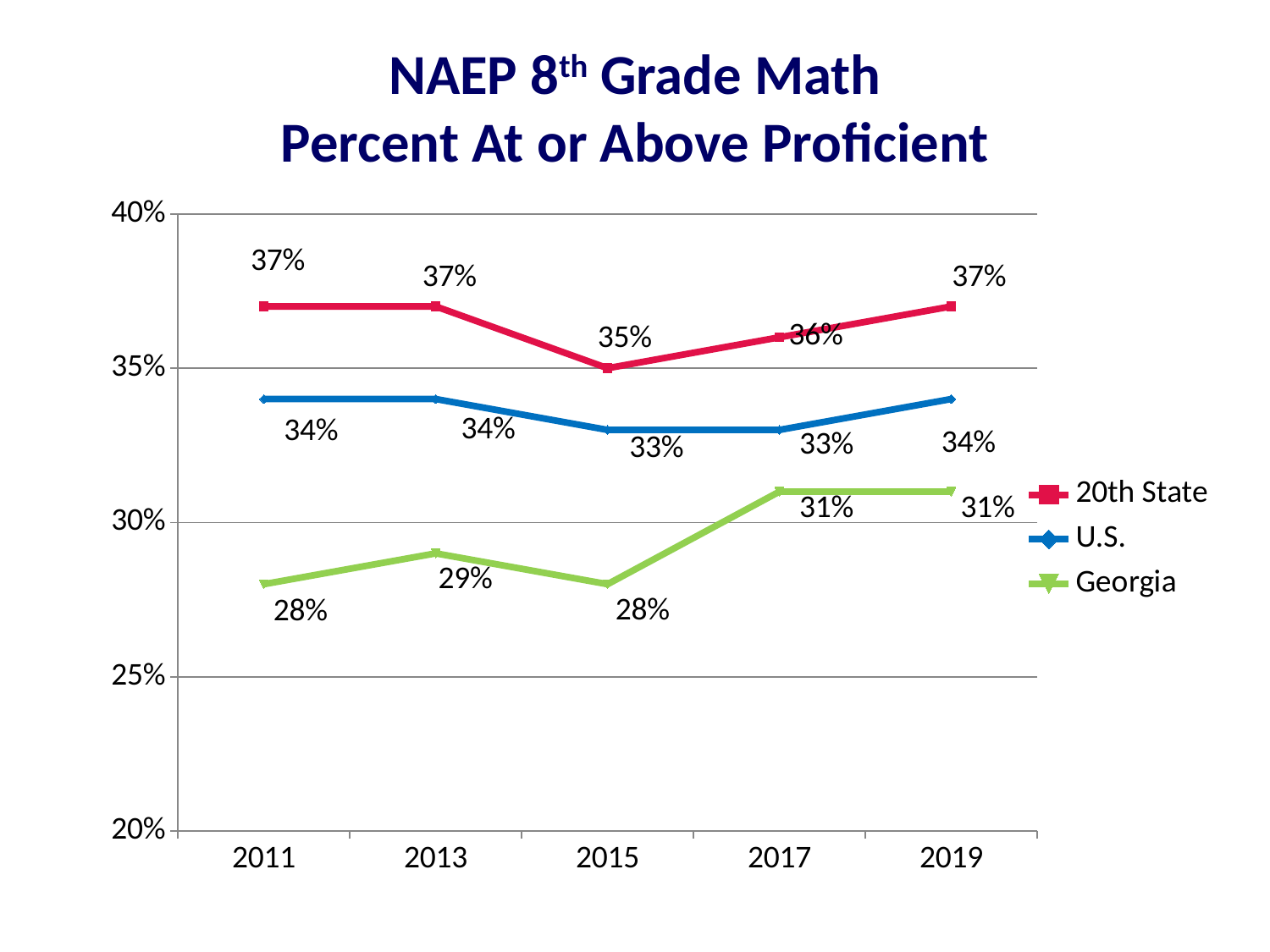
Which was higher in 2017, the U.S. or Georgia? U.S. What is the difference between the 20th State value and Georgia's value in 2011? 9 percentage points How many years are shown on the x axis? 5 What was the 20th State value in 2017? 36% In which year was Georgia's value lowest? 2011 and 2015 What was the U.S. value in 2019? 34% How many series does the legend list? 3 In which year was the 20th State value lowest? 2015 What is the difference between the U.S. value and Georgia's value in 2019? 3 percentage points Did Georgia's value rise or fall from 2015 to 2017? Rise What was Georgia's percent at or above proficient in 2015? 28% What kind of chart is this? Line chart